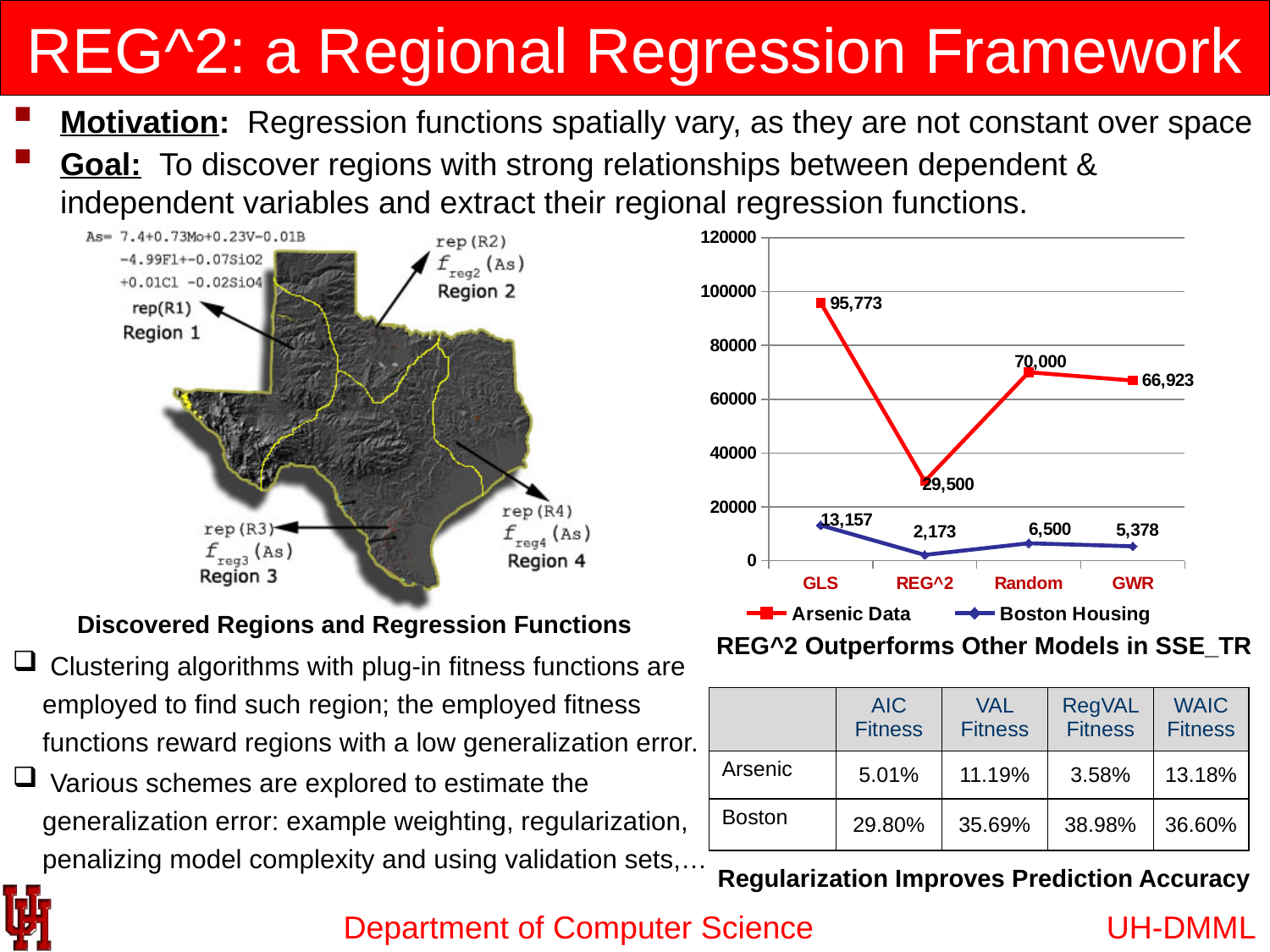
What is the Arsenic Data value for Random? 70,000 Is the Arsenic Data value for GWR greater or less than 60000? greater Which model has the highest Boston Housing value? GLS What is the Boston Housing value for REG^2? 2,173 What type of chart is shown on the slide? line chart Which is larger, the Boston Housing value for Random or for GWR? Random What is the Arsenic Data value for GLS? 95,773 How many series does the chart legend list? 2 Which model has the lowest Arsenic Data value? REG^2 How many models are shown on the x axis of the chart? 4 What is the difference between the Arsenic Data values for GLS and REG^2? 66,273 What is the Boston Housing value for GWR? 5,378